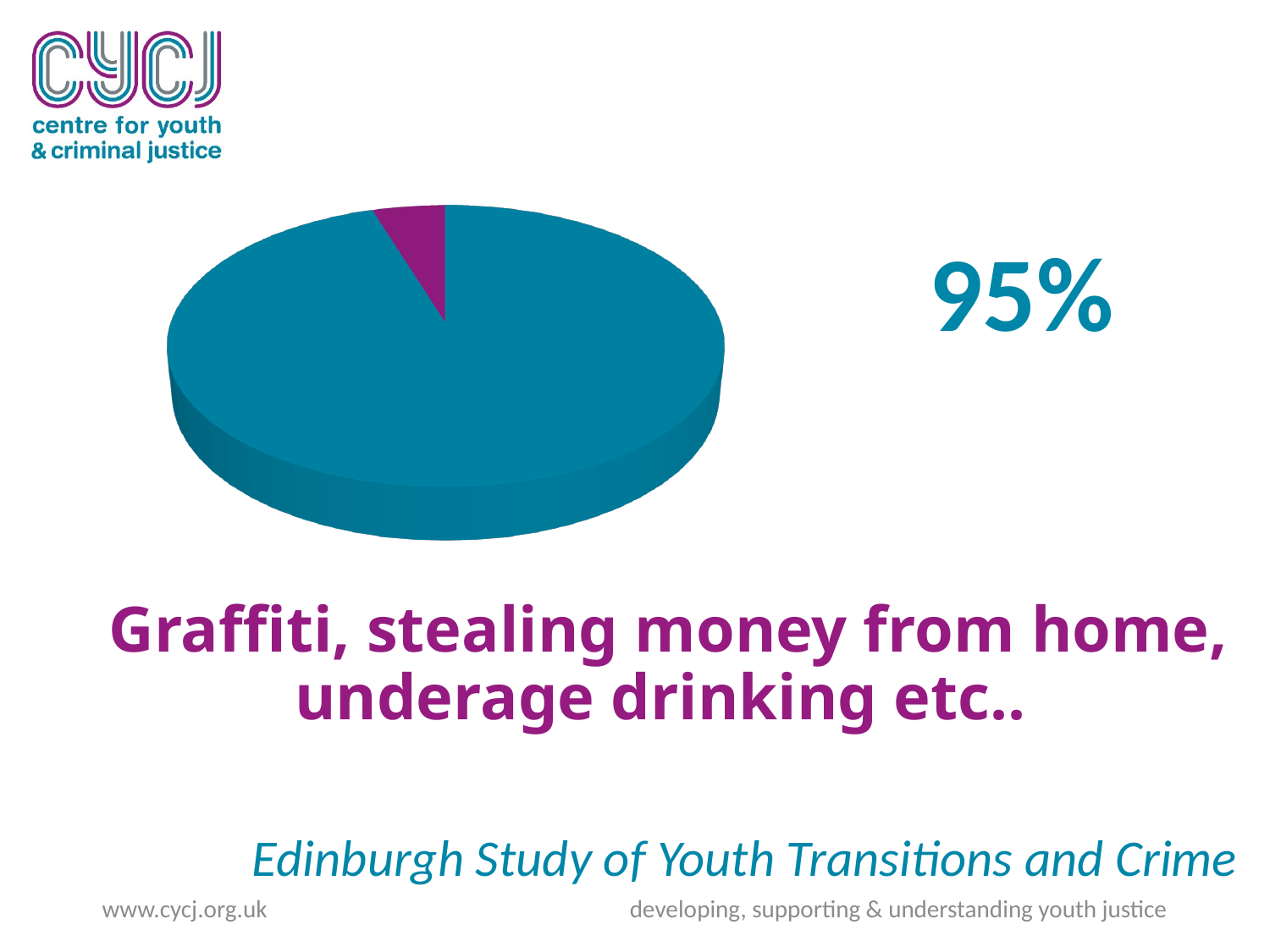
Which slice of the pie chart is larger, the teal one or the purple one? the teal one Is the purple slice's share of the pie greater or less than 10%? less What share of the pie does the small purple slice represent? 5% What percentage is printed next to the pie chart? 95% What text appears directly below the pie chart? Graffiti, stealing money from home, underage drinking etc.. What share of the pie does the large teal slice represent? 95% What colour is the smallest slice of the pie chart? purple What kind of chart is shown on the slide? pie chart Is the teal slice's share of the pie greater or less than 50%? greater How many slices does the pie chart have? 2